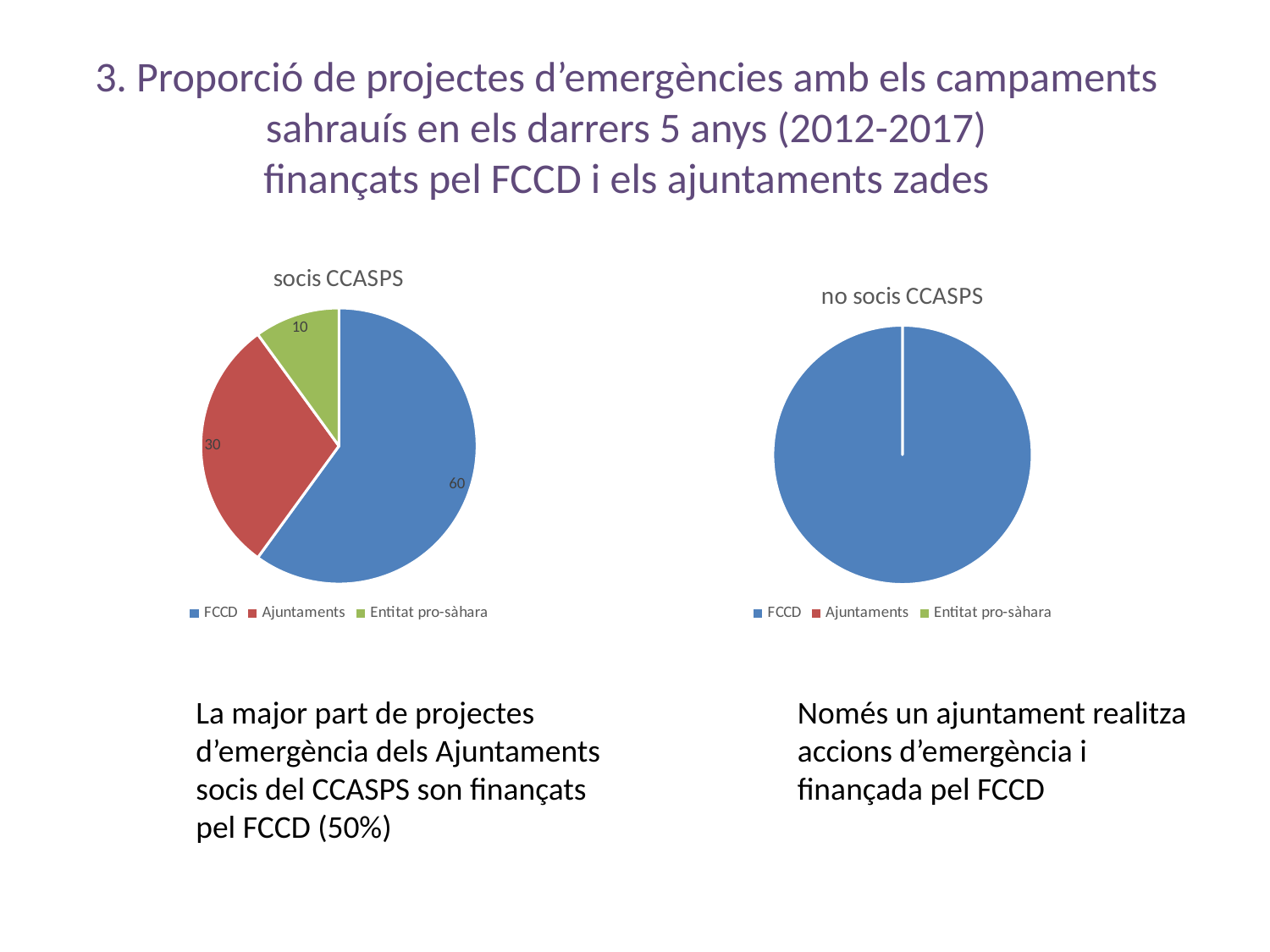
In the 'socis CCASPS' chart, what is the difference between the FCCD value and the Ajuntaments value? 30 In the 'socis CCASPS' chart, which category has the largest slice? FCCD In the 'socis CCASPS' chart, which category has the smallest slice? Entitat pro-sàhara In the 'socis CCASPS' chart, what is the value for Entitat pro-sàhara? 10 What kind of chart is the 'no socis CCASPS' chart? Pie chart In the 'socis CCASPS' chart, what share of the pie does FCCD represent? 60% In the 'no socis CCASPS' chart, which category fills the entire pie? FCCD In the 'socis CCASPS' chart, what is the value for FCCD? 60 How many entries does the legend of the 'no socis CCASPS' chart list? 3 In the 'socis CCASPS' chart, what is the total of all the slices? 100 In the 'socis CCASPS' chart, what is the value for Ajuntaments? 30 In the 'socis CCASPS' chart, which is larger, Ajuntaments or Entitat pro-sàhara? Ajuntaments